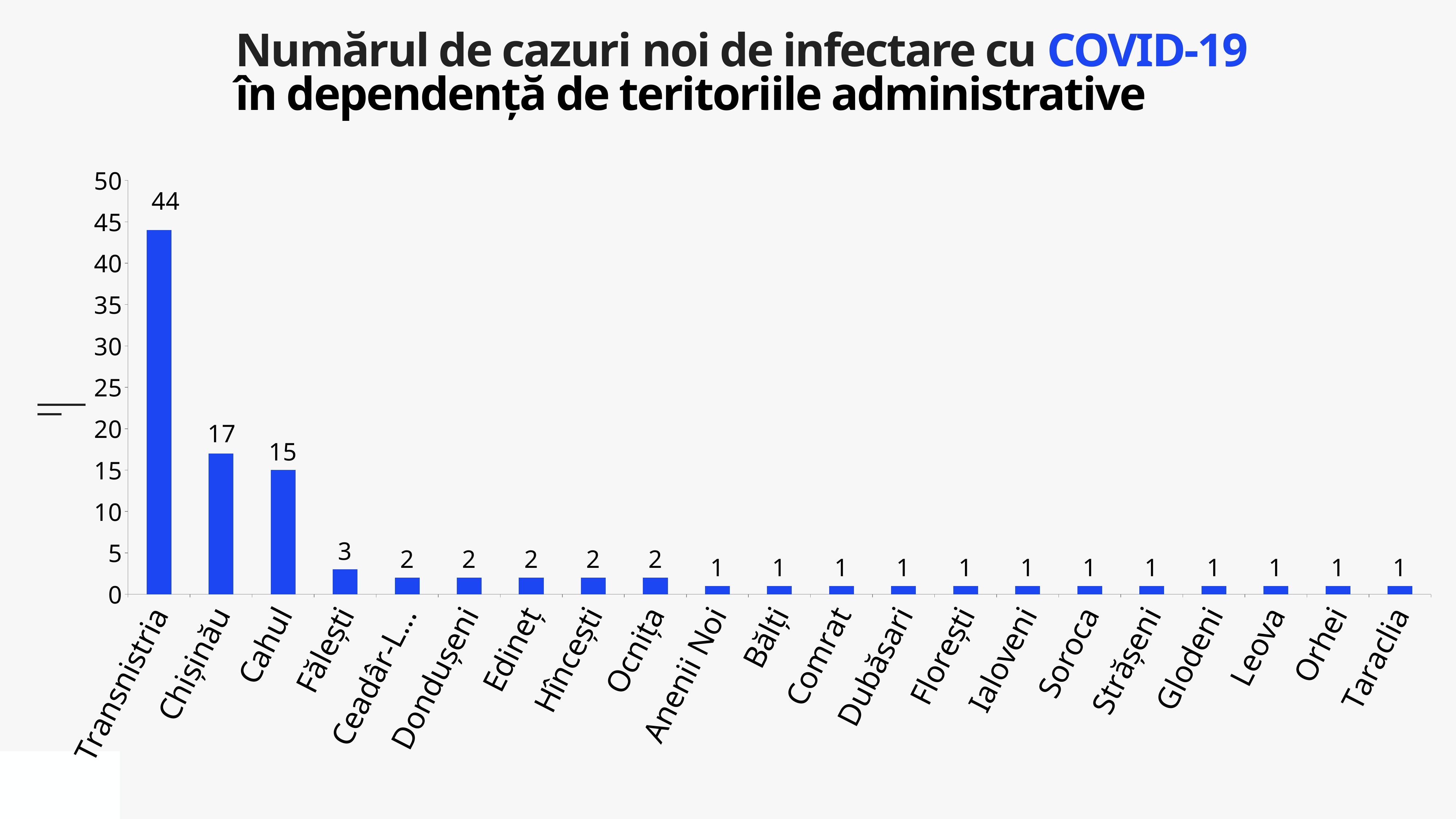
What is the value for Fălești? 3 What is the value for Ocnița? 2 What is the value for Transnistria? 44 Which territory has the highest number of new cases? Transnistria What is the difference between the values for Transnistria and Chișinău? 27 What is the difference between the values for Chișinău and Cahul? 2 What is the value for Cahul? 15 Which is larger, the value for Cahul or the value for Fălești? Cahul Is the value for Transnistria greater or less than 40? greater What kind of chart is shown on the slide? bar chart How many territories are shown on the x axis? 21 What is the value for Chișinău? 17